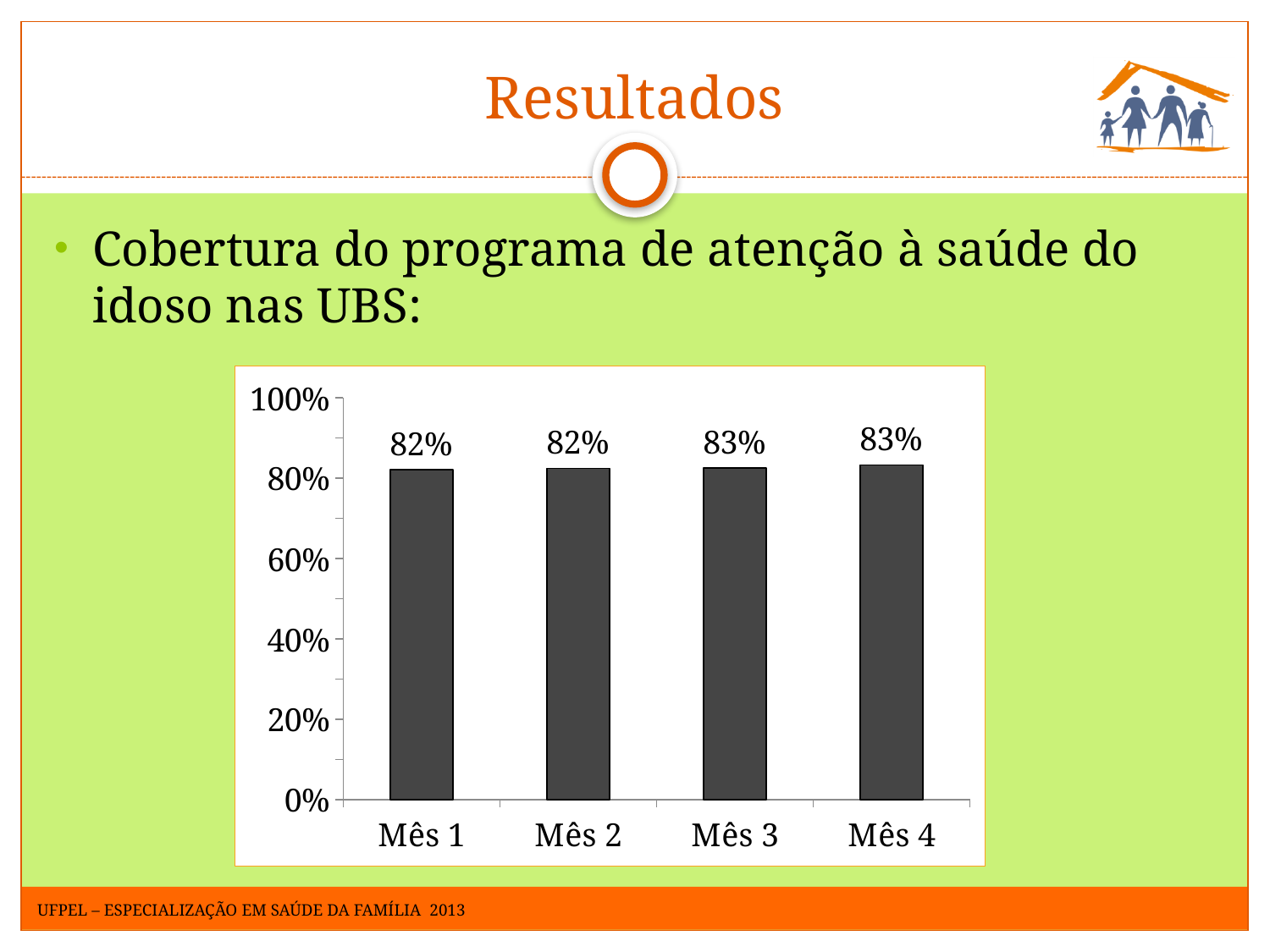
How many categories are shown on the x axis? 4 What is the value for Mês 3? 83% What is the difference between the values for Mês 4 and Mês 1? 1 percentage point What is the value for Mês 2? 82% What kind of chart is shown on the slide? bar chart What is the highest tick value shown on the y axis? 100% What is the value for Mês 4? 83% What is the value for Mês 1? 82% Which is larger, the value for Mês 1 or the value for Mês 3? Mês 3 Is the value for Mês 2 greater or less than 60%? greater Is the value for Mês 4 greater or less than 100%? less Do the values rise or fall from Mês 1 to Mês 4? rise